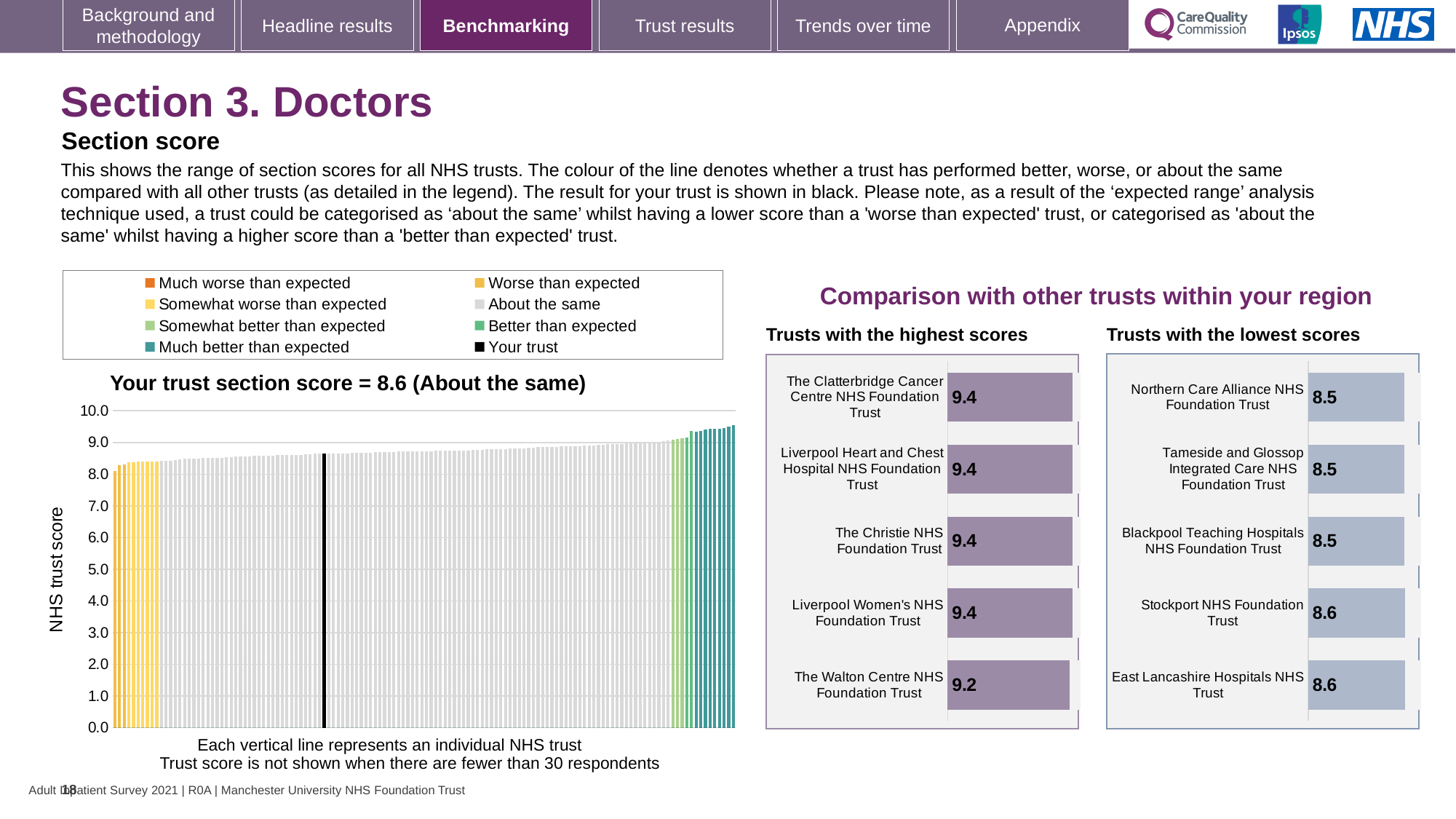
In the 'Trusts with the highest scores' chart, what is the difference between the score for The Christie NHS Foundation Trust and The Walton Centre NHS Foundation Trust? 0.2 In the 'Your trust section score' chart, what is the label on the y axis? NHS trust score In the 'Your trust section score' chart, do the trust scores rise or fall from left to right along the x axis? rise In the 'Trusts with the lowest scores' chart, how many trusts are shown? 5 In the 'Trusts with the lowest scores' chart, which has the larger score, Stockport NHS Foundation Trust or Northern Care Alliance NHS Foundation Trust? Stockport NHS Foundation Trust In the 'Trusts with the highest scores' chart, which trust has the lowest score? The Walton Centre NHS Foundation Trust In the 'Your trust section score' chart, how many entries does the legend list? 8 In the 'Your trust section score' chart, what kind of chart is shown? bar chart In the 'Your trust section score' chart, is the value for your trust greater or less than 8.0? greater In the 'Trusts with the highest scores' chart, what is the score for The Walton Centre NHS Foundation Trust? 9.2 In the 'Trusts with the lowest scores' chart, what is the score for Blackpool Teaching Hospitals NHS Foundation Trust? 8.5 In the 'Your trust section score' chart, what is the section score for your trust? 8.6